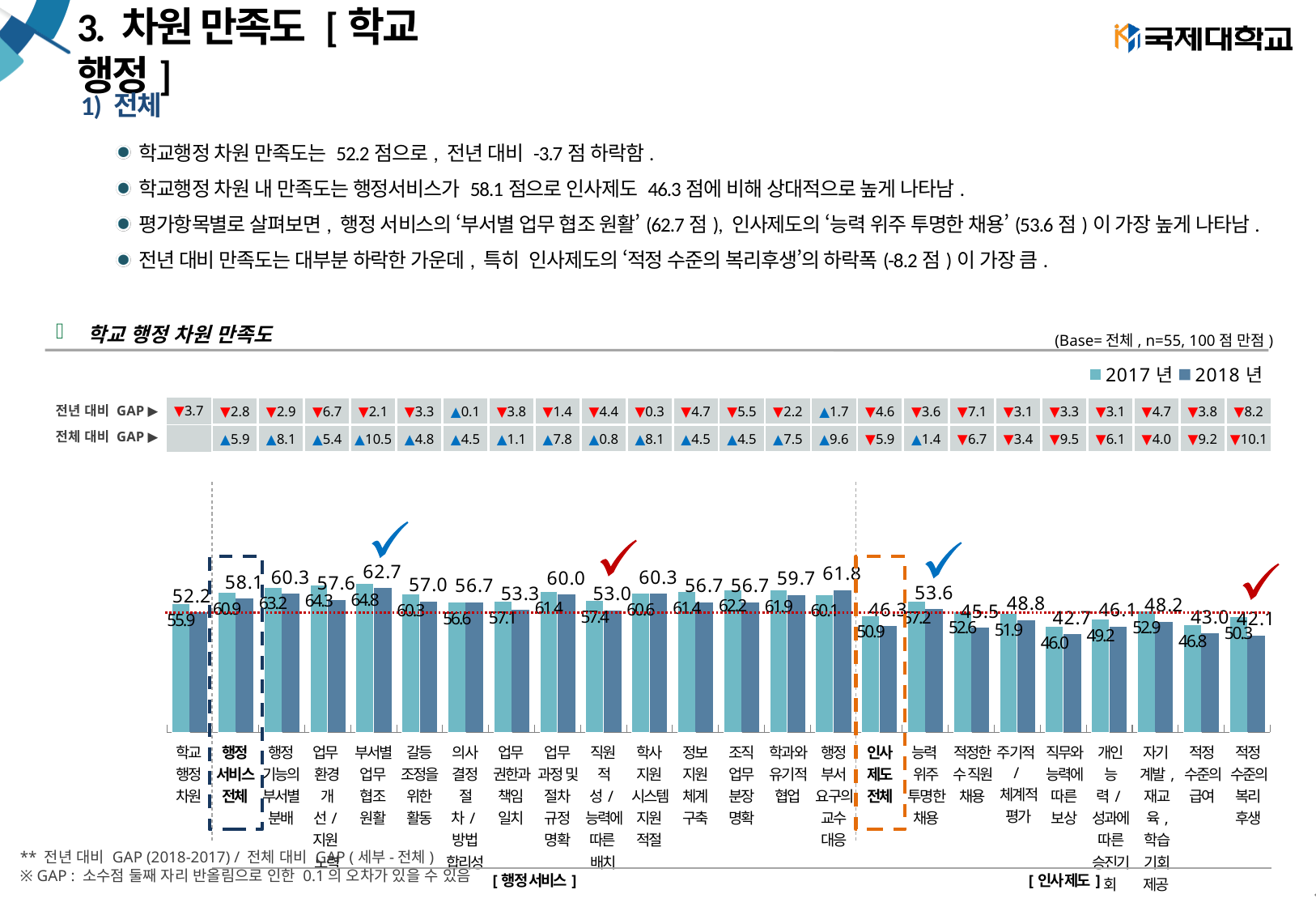
What is the 2017년 value for 학교행정차원? 55.9 Which is larger for 행정서비스 전체, the 2017년 value or the 2018년 value? 2017년 Which category has the lowest 2018년 value? 적정 수준의 복리후생 Which two series are listed in the chart legend? 2017년 and 2018년 What is the difference between the 2017년 and 2018년 values for 적정 수준의 복리후생? 8.2 What is the 2018년 value for 적정 수준의 복리후생? 42.1 What type of chart is shown on the slide? bar chart How many series does the chart legend list? 2 What is the 2018년 value for 부서별 업무 협조 원활? 62.7 What is the 2018년 value for 인사제도 전체? 46.3 Which category has the highest 2018년 value? 부서별 업무 협조 원활 What is the 2018년 value for 학교행정차원? 52.2